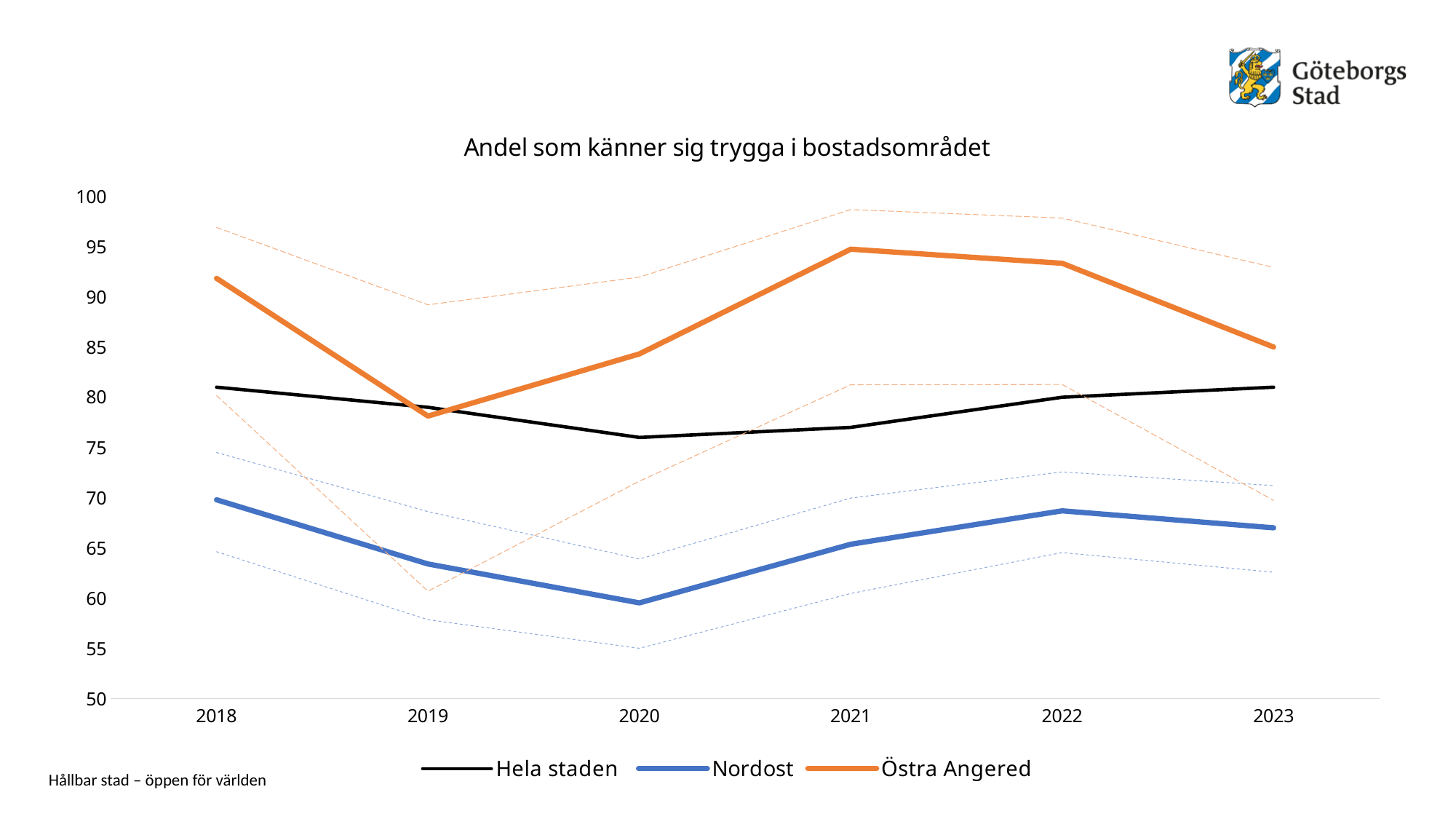
In which year is the Östra Angered line at its lowest? 2019 In which year is the Nordost line at its lowest? 2020 Which colour is used for the Östra Angered line? Orange Is the value for Hela staden in 2020 greater or less than 80? less Is the value for Östra Angered in 2021 greater or less than 90? greater In 2023, which is higher: Östra Angered or Hela staden? Östra Angered How many series does the legend list? 3 Is the value for Nordost in 2020 greater or less than 65? less How many years are shown on the x axis? 6 Does the Östra Angered line rise or fall from 2021 to 2023? Fall What is the title of the chart? Andel som känner sig trygga i bostadsområdet What kind of chart is shown on the slide? Line chart